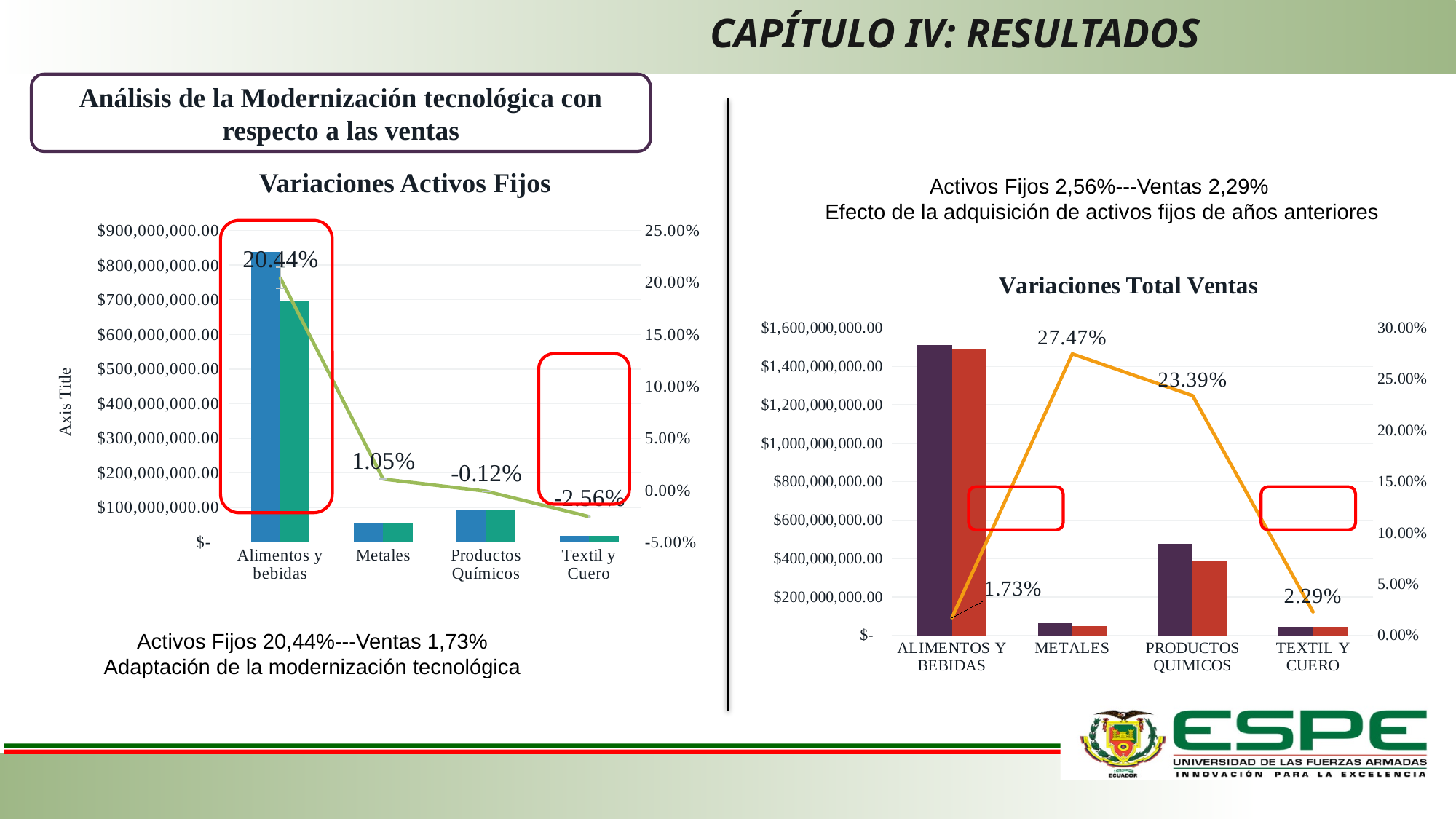
In the 'Variaciones Total Ventas' chart, is the first bar for Alimentos y Bebidas greater or less than $1,400,000,000.00? greater In the 'Variaciones Activos Fijos' chart, what is the difference between the labelled percentages for Alimentos y bebidas and Metales? 19.39% In the 'Variaciones Total Ventas' chart, what percentage is labelled for Alimentos y Bebidas? 1.73% In the 'Variaciones Activos Fijos' chart, what percentage is labelled for Textil y Cuero? -2.56% In the 'Variaciones Activos Fijos' chart, do the labelled percentages rise or fall from left to right along the x axis? fall In the 'Variaciones Activos Fijos' chart, which category has the lowest labelled percentage? Textil y Cuero In the 'Variaciones Activos Fijos' chart, what percentage is labelled for Alimentos y bebidas? 20.44% In the 'Variaciones Total Ventas' chart, which category has the highest labelled percentage? Metales In the 'Variaciones Total Ventas' chart, what percentage is labelled for Metales? 27.47% In the 'Variaciones Activos Fijos' chart, is the first bar for Alimentos y bebidas greater or less than $700,000,000.00? greater How many categories are shown on the x axis of the 'Variaciones Total Ventas' chart? 4 In the 'Variaciones Total Ventas' chart, what is the difference between the labelled percentages for Metales and Productos Quimicos? 4.08%